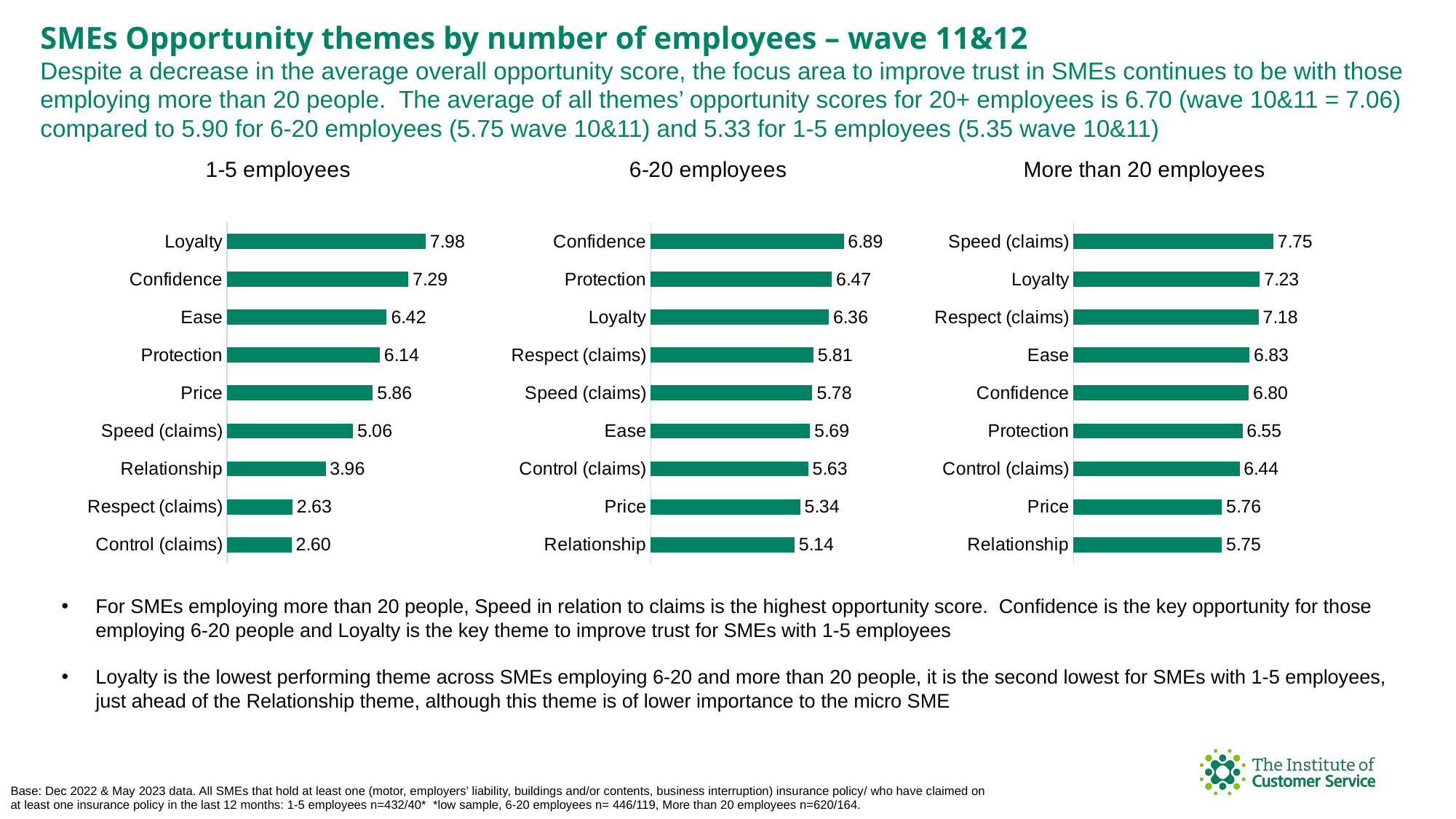
In the 'More than 20 employees' chart, what is the value for Control (claims)? 6.44 How many themes are shown in the '1-5 employees' chart? 9 In the '6-20 employees' chart, which theme has the highest value? Confidence What kind of chart is the 'More than 20 employees' chart? Bar chart In the 'More than 20 employees' chart, which theme has the lowest value? Relationship In the '1-5 employees' chart, what is the difference between Loyalty and Confidence? 0.69 In the '6-20 employees' chart, what is the value for Protection? 6.47 In the '1-5 employees' chart, which theme has the lowest value? Control (claims) In the '6-20 employees' chart, which is larger: Ease or Price? Ease How many separate charts are shown on the slide? 3 In the '1-5 employees' chart, what is the value for Loyalty? 7.98 In the 'More than 20 employees' chart, what is the difference between Speed (claims) and Price? 1.99